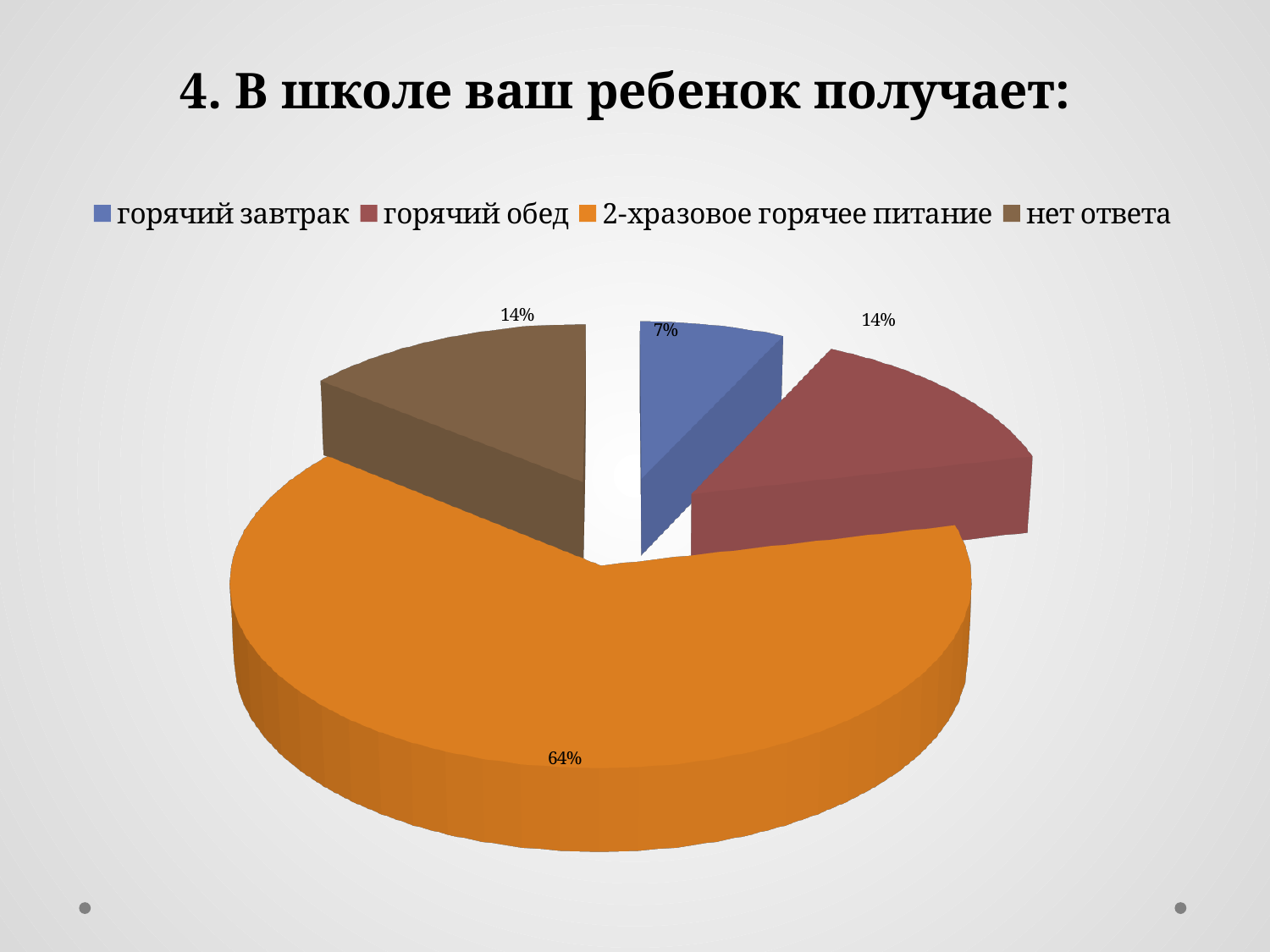
How many slices does the pie chart have? 4 What share of the pie is labelled for "нет ответа"? 14% What is the difference in percentage points between "2-хразовое горячее питание" and "горячий обед"? 50 Which category has the smallest slice of the pie? горячий завтрак How many entries does the legend list? 4 What share of the pie is labelled for "горячий обед"? 14% Which is larger: the slice for "горячий обед" or the slice for "горячий завтрак"? горячий обед What share of the pie is labelled for "2-хразовое горячее питание"? 64% What colour is the slice for "нет ответа"? brown What share of the pie is labelled for "горячий завтрак"? 7% What kind of chart is shown on the slide? pie chart Which category has the largest slice of the pie? 2-хразовое горячее питание